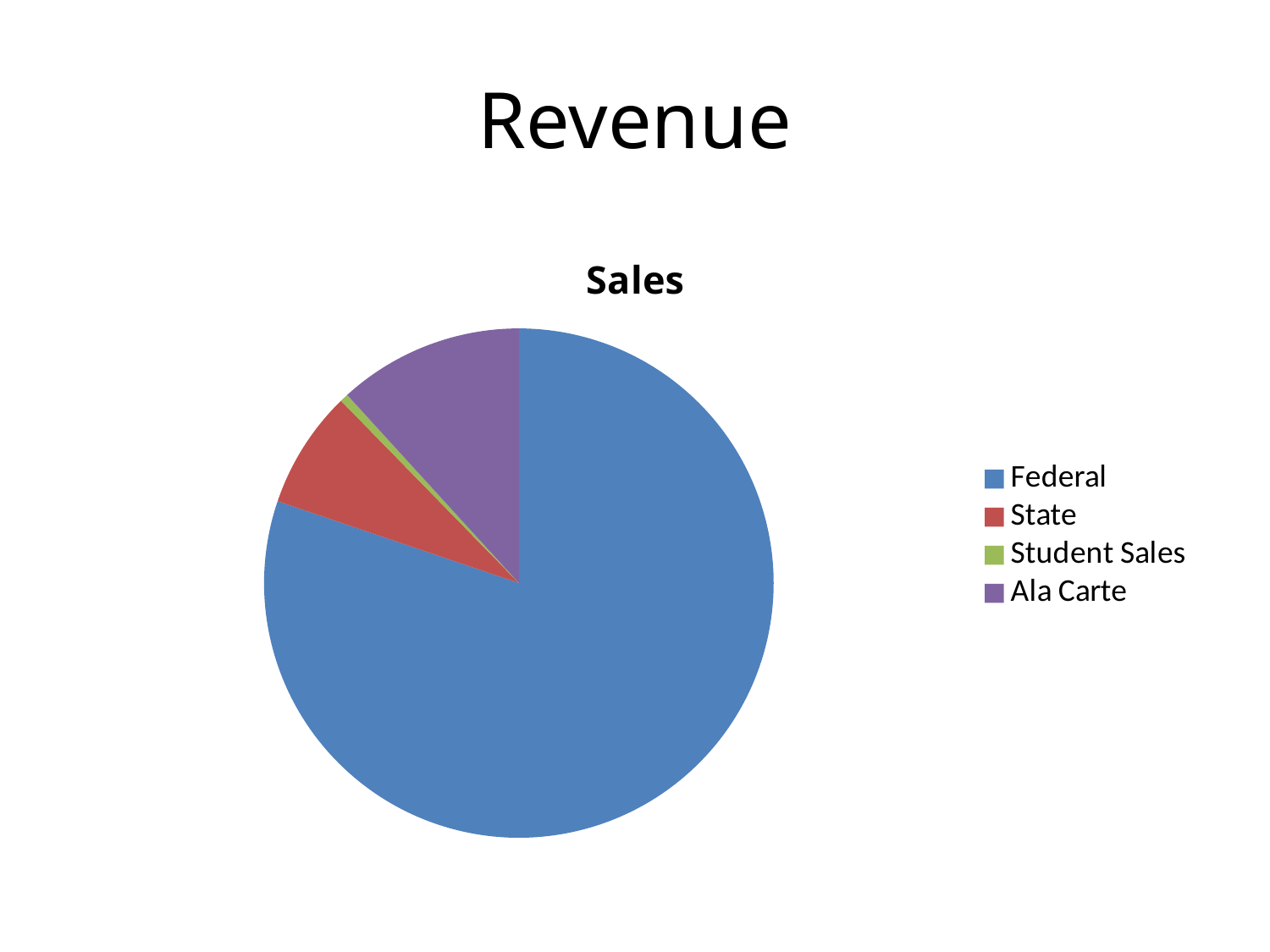
Which category has the smallest slice of the pie? Student Sales What is the title of the chart? Sales How many categories does the pie chart show? 4 Does the Federal slice make up more or less than half of the pie? more Which category has the largest slice of the pie? Federal Which category is shown in blue? Federal Which slice is larger, Federal or Ala Carte? Federal Which slice is larger, State or Student Sales? State What kind of chart is shown on the slide? pie chart Which slice is larger, Ala Carte or State? Ala Carte